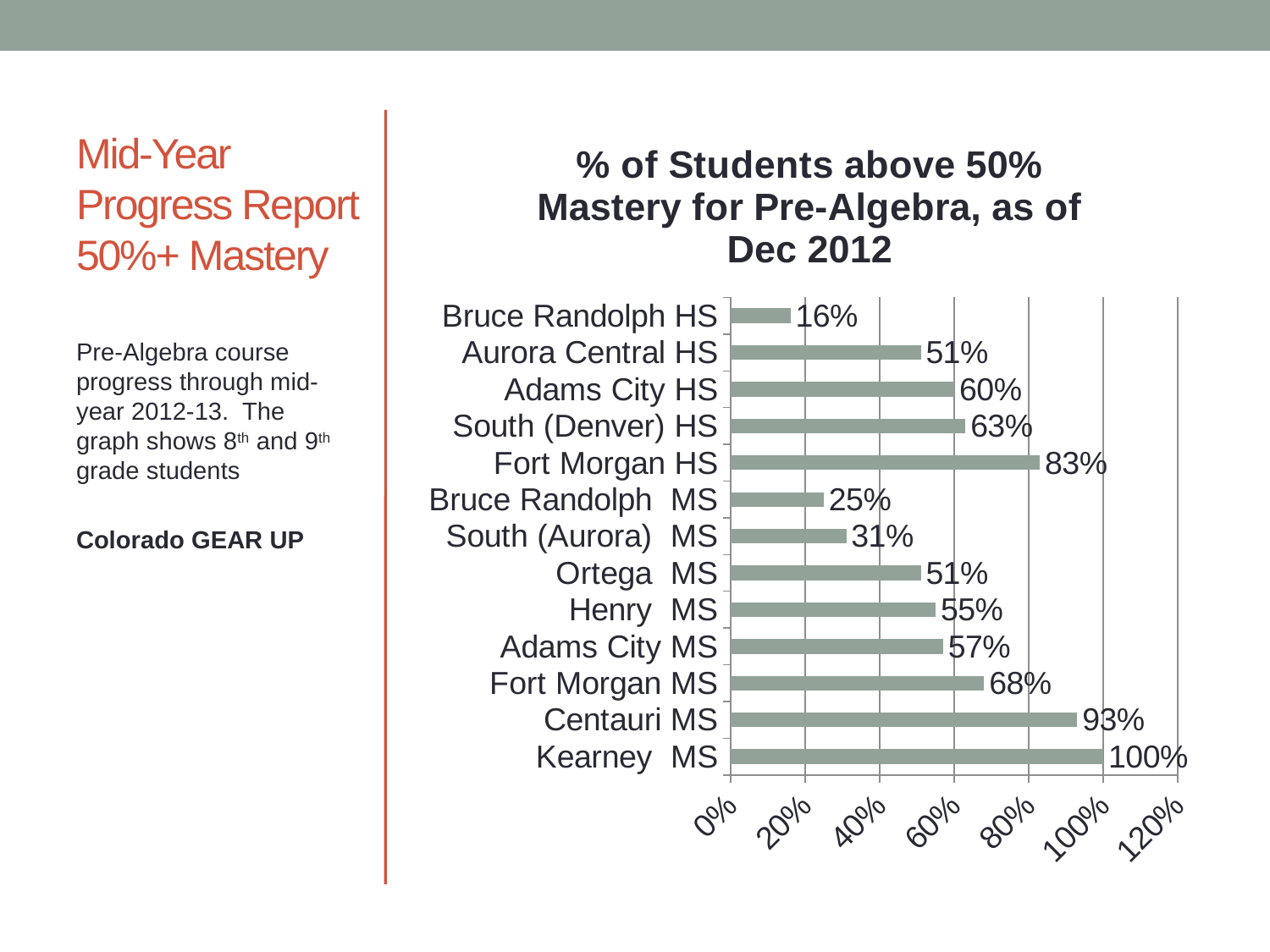
Which school has the lowest percentage of students above 50% mastery? Bruce Randolph HS Is the value for South (Aurora) MS greater or less than 40%? less What is the title of the chart? % of Students above 50% Mastery for Pre-Algebra, as of Dec 2012 What is the value for Bruce Randolph MS? 25% What kind of chart is shown on the slide? bar chart Which is larger, the value for Adams City HS or the value for Adams City MS? Adams City HS What is the difference between the values for Fort Morgan HS and Fort Morgan MS? 15% What is the value for Fort Morgan HS? 83% What is the value for Centauri MS? 93% What is the difference between the values for Kearney MS and Bruce Randolph HS? 84% Which school has the highest percentage of students above 50% mastery? Kearney MS How many schools are shown in the chart? 13